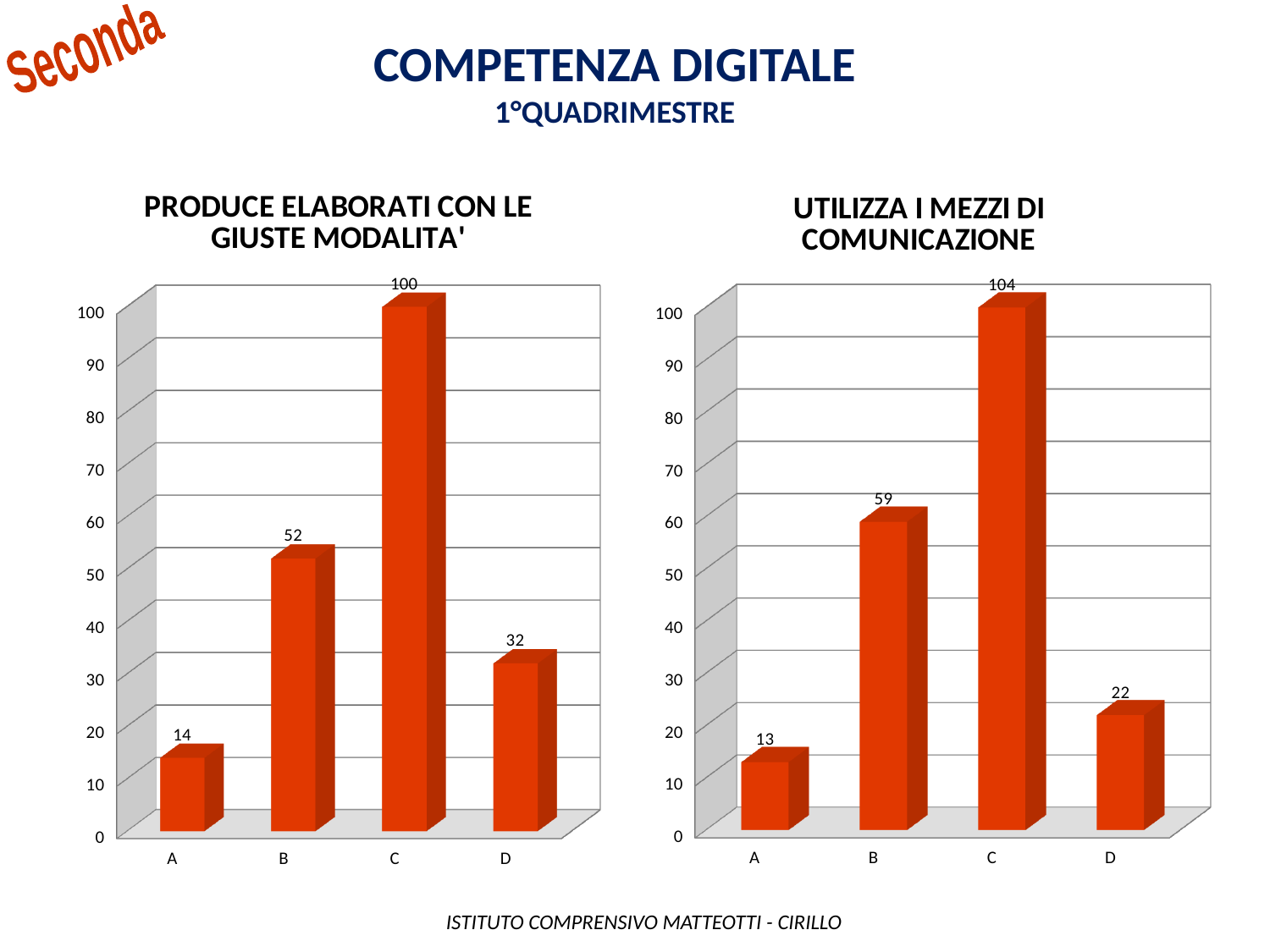
In the chart titled 'PRODUCE ELABORATI CON LE GIUSTE MODALITA'', which category has the lowest value? A In the chart titled 'UTILIZZA I MEZZI DI COMUNICAZIONE', what is the value for category A? 13 In the chart titled 'UTILIZZA I MEZZI DI COMUNICAZIONE', what is the difference between the values for C and A? 91 In the chart titled 'PRODUCE ELABORATI CON LE GIUSTE MODALITA'', what is the difference between the values for B and D? 20 In the chart titled 'PRODUCE ELABORATI CON LE GIUSTE MODALITA'', what is the value for category D? 32 What is the title of the chart on the right side of the slide? UTILIZZA I MEZZI DI COMUNICAZIONE In the chart titled 'UTILIZZA I MEZZI DI COMUNICAZIONE', which is larger, the value for A or the value for D? D In the chart titled 'PRODUCE ELABORATI CON LE GIUSTE MODALITA'', what is the value for category C? 100 In the chart titled 'PRODUCE ELABORATI CON LE GIUSTE MODALITA'', how many categories are shown on the x axis? 4 In the chart titled 'UTILIZZA I MEZZI DI COMUNICAZIONE', which category has the highest value? C In the chart titled 'UTILIZZA I MEZZI DI COMUNICAZIONE', what is the value for category B? 59 What kind of chart is the chart titled 'UTILIZZA I MEZZI DI COMUNICAZIONE'? bar chart